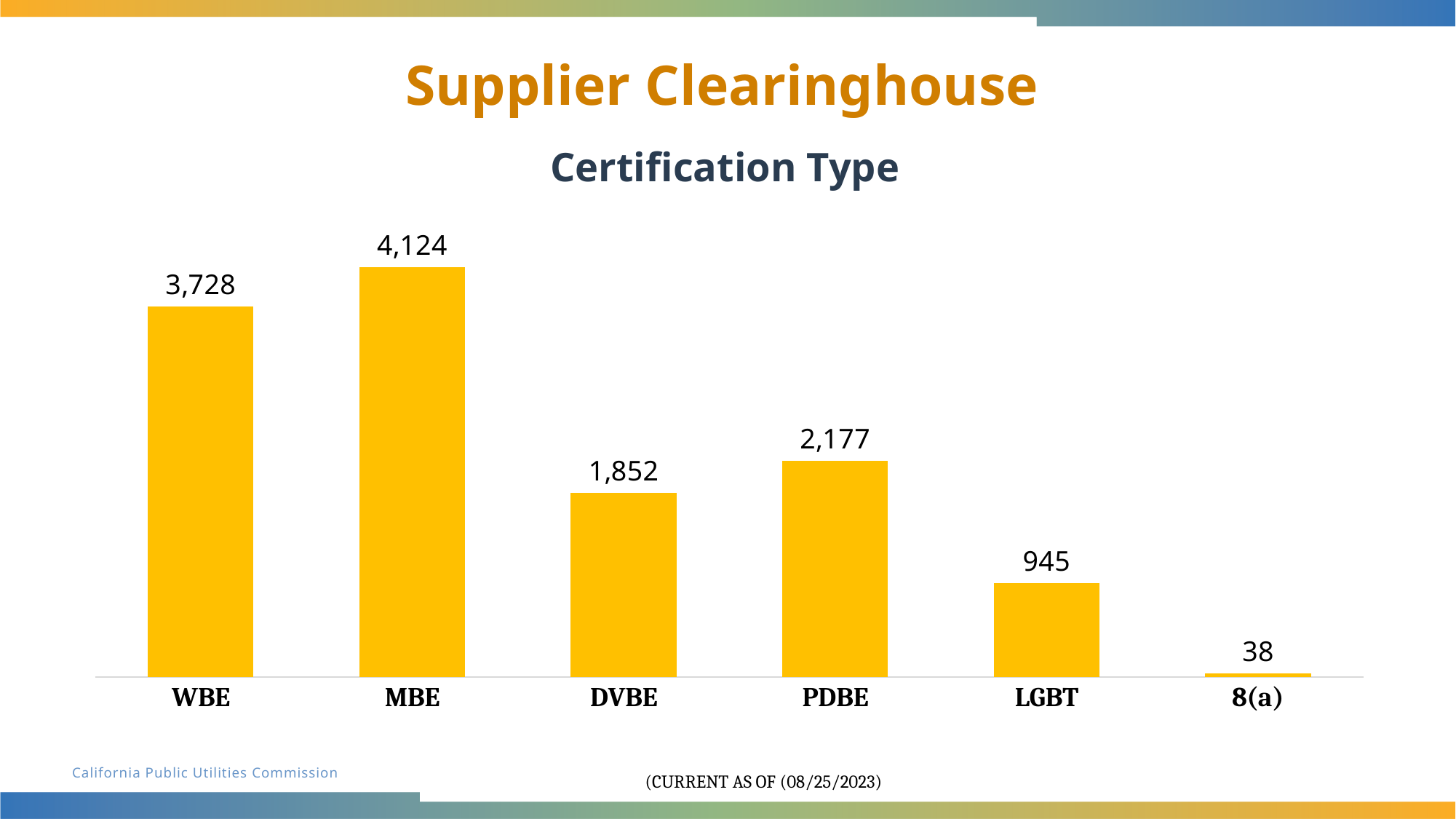
Which certification type has the highest value? MBE How many certification types are shown in the chart? 6 What is the difference between the values for PDBE and DVBE? 325 Which certification type has the lowest value? 8(a) What is the value for DVBE? 1,852 What is the value for MBE? 4,124 What kind of chart is shown on the slide? Bar chart What is the difference between the values for MBE and WBE? 396 What is the value for LGBT? 945 Which is larger, the value for PDBE or the value for DVBE? PDBE What is the value for 8(a)? 38 What is the title of the chart? Certification Type